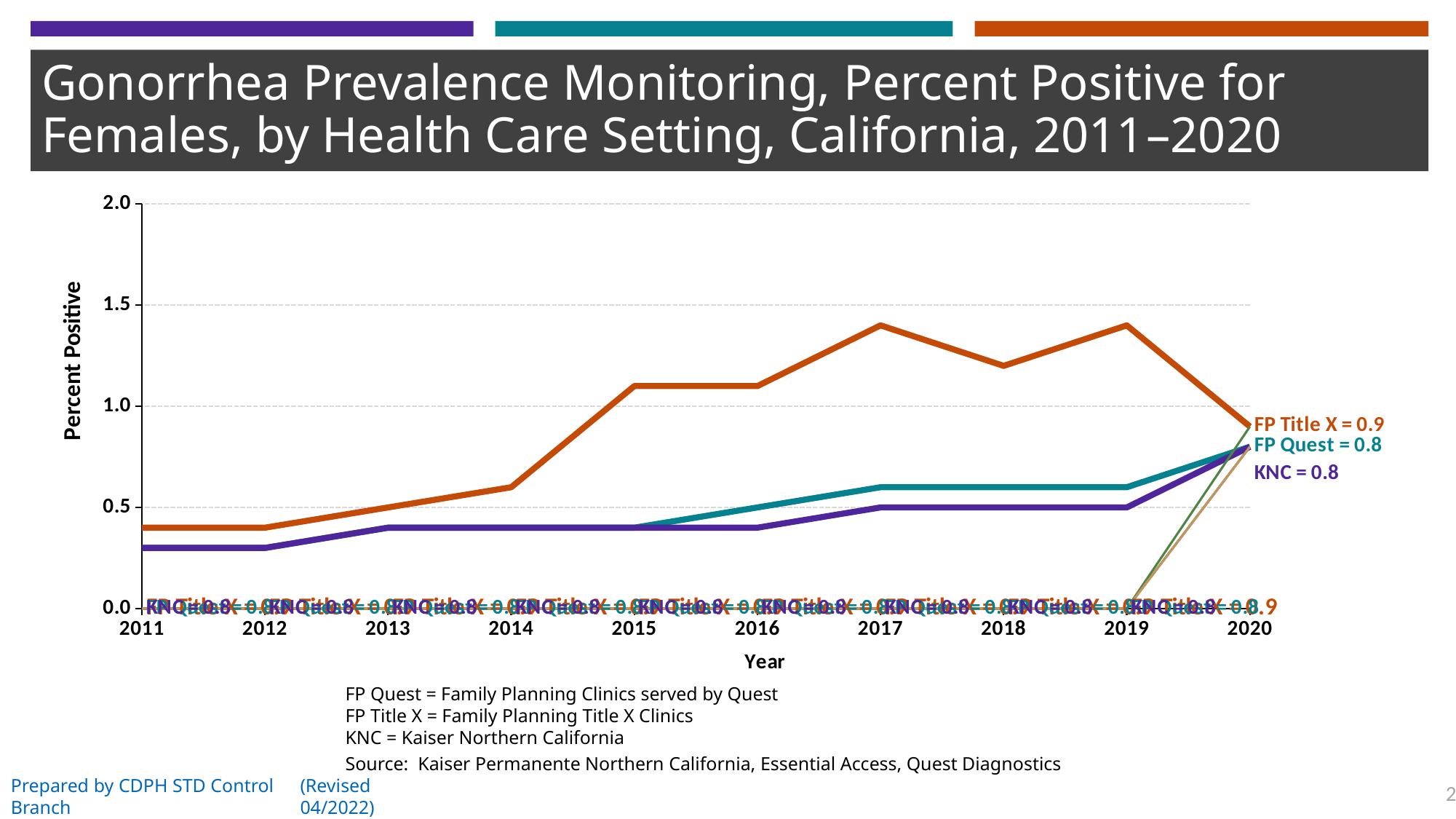
What is the value for FP Title X in 2020? 0.9 What is the value for KNC in 2020? 0.8 In 2020, which is larger, FP Title X or FP Quest? FP Title X How many years are plotted along the x axis? 10 Is the value for FP Title X in 2017 greater or less than 1.0? greater What is the value for FP Quest in 2020? 0.8 What kind of chart is shown on the slide? Line chart Does the FP Title X line rise or fall from 2019 to 2020? Fall What is the difference between FP Title X and FP Quest in 2020? 0.1 Which series has the highest value in 2017? FP Title X Is the value for KNC in 2011 greater or less than 0.5? less How many series are plotted on the chart? 3